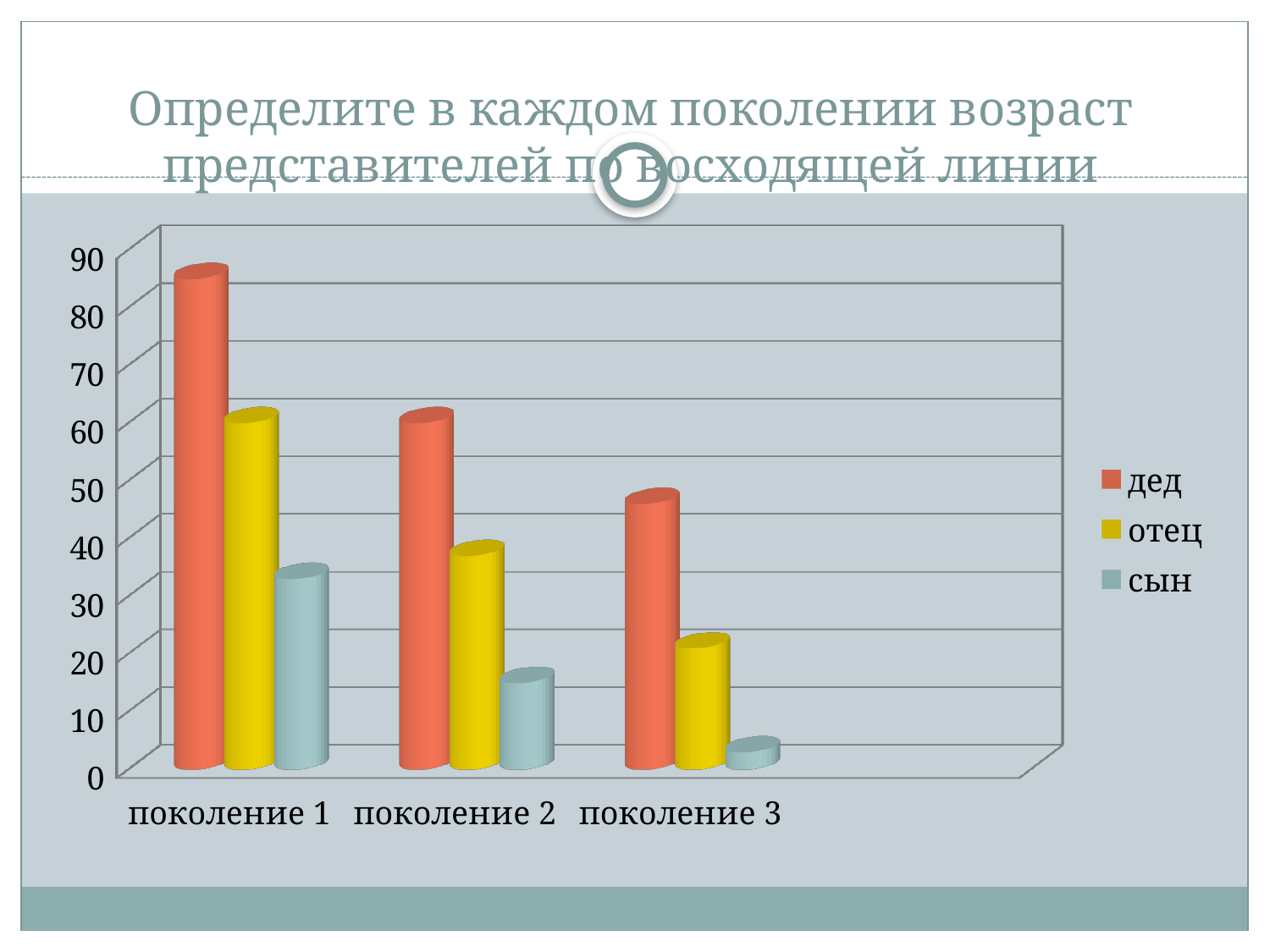
Is the value for отец in поколение 3 greater or less than 30? less How many categories (generations) are shown on the x axis? 3 Is the value for дед in поколение 1 greater or less than 80? greater Is the value for дед in поколение 2 greater or less than 70? less Which series has the highest bar in поколение 1? дед What kind of chart is shown on the slide? bar chart What are the three legend entries of the chart? дед, отец, сын Which series has the lowest bar in поколение 3? сын How many series does the legend list? 3 Which is larger: дед in поколение 3 or отец in поколение 2? дед in поколение 3 Do the values for дед rise or fall from поколение 1 to поколение 3? fall